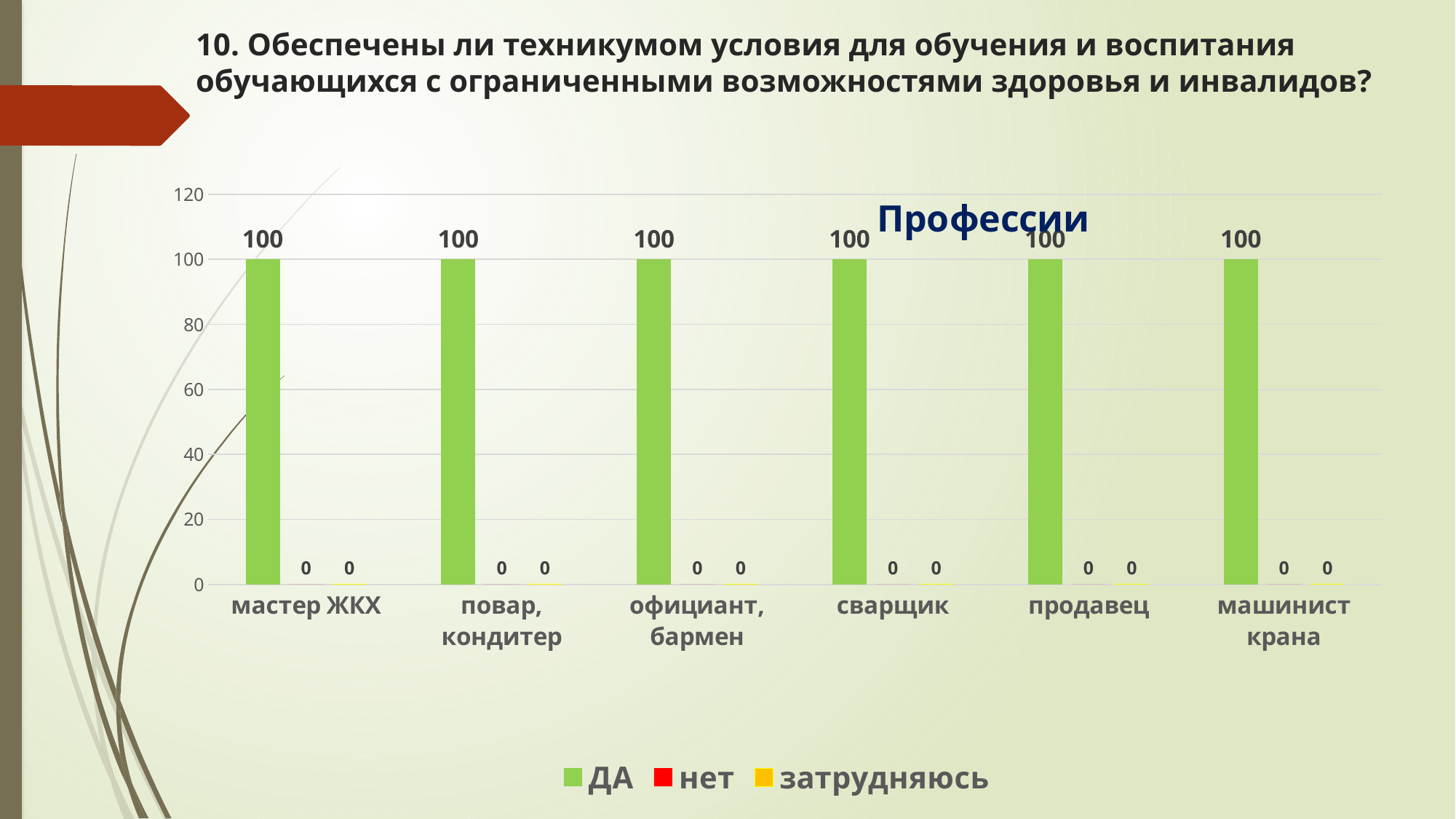
What kind of chart is shown on the slide? bar chart What is the value of the нет series for продавец? 0 Is the ДА value for продавец greater or less than 80? greater What label is printed in blue above the bars on the chart? Профессии How many categories are shown on the x axis? 6 Which series is shown in green in the legend? ДА What is the value of the ДА series for машинист крана? 100 What is the value of the ДА series for сварщик? 100 For официант, бармен, which is larger: the ДА value or the затрудняюсь value? ДА What is the difference between the ДА value and the нет value for повар, кондитер? 100 What is the value of the затрудняюсь series for мастер ЖКХ? 0 How many series does the legend list? 3